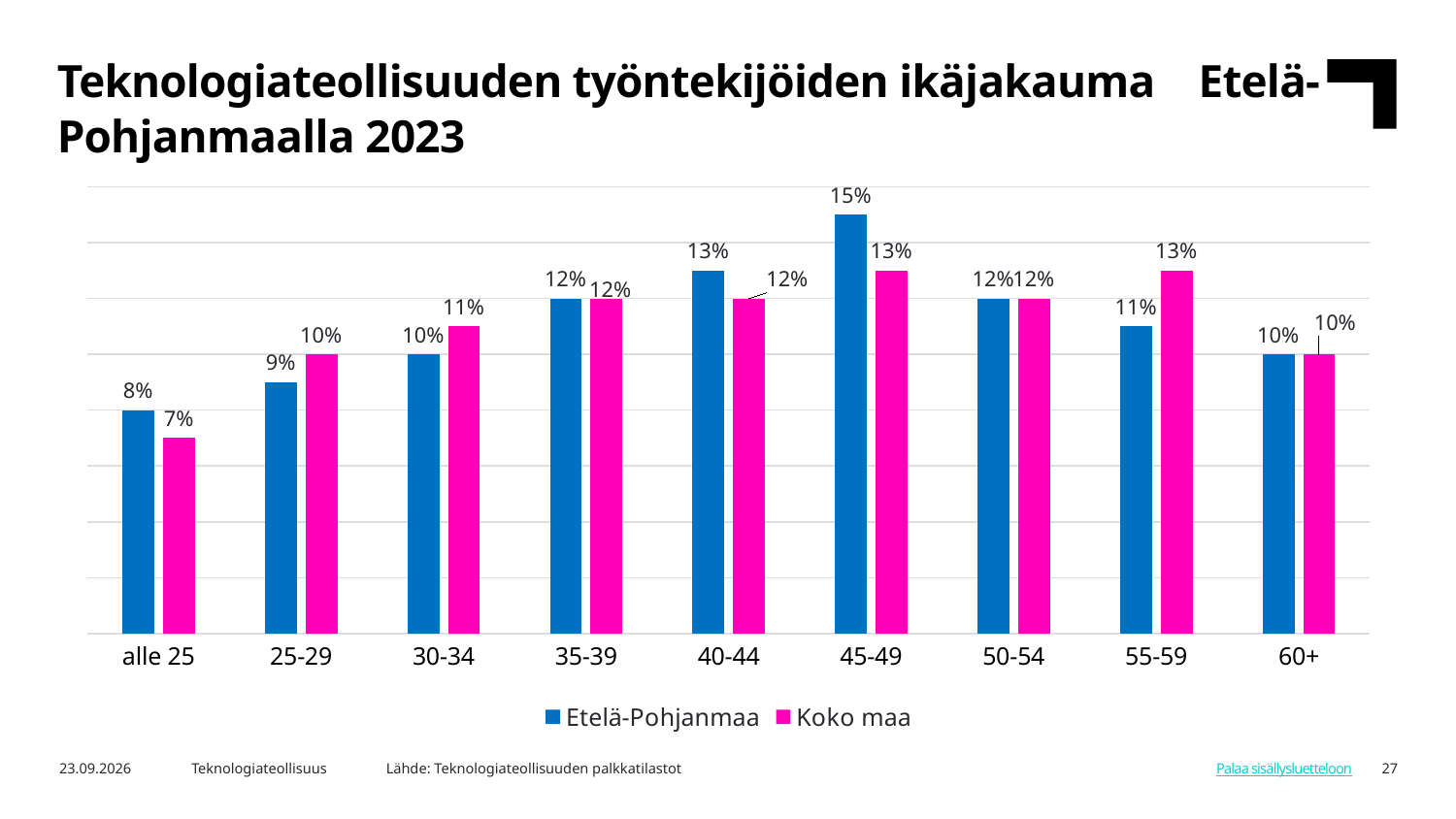
In the 55-59 age group, which series has the larger value, Etelä-Pohjanmaa or Koko maa? Koko maa How many series does the legend list? 2 What is the difference between the Etelä-Pohjanmaa and Koko maa values in the 45-49 age group? 2 percentage points What is the value for Koko maa in the alle 25 age group? 7% What is the value for Koko maa in the 55-59 age group? 13% Which age group has the highest value for Etelä-Pohjanmaa? 45-49 How many age groups are shown on the x axis? 9 Which colour represents the Koko maa series? Pink What is the value for Etelä-Pohjanmaa in the 45-49 age group? 15% What is the value for Etelä-Pohjanmaa in the 40-44 age group? 13% What kind of chart is shown on the slide? Bar chart Which age group has the lowest value for Koko maa? alle 25